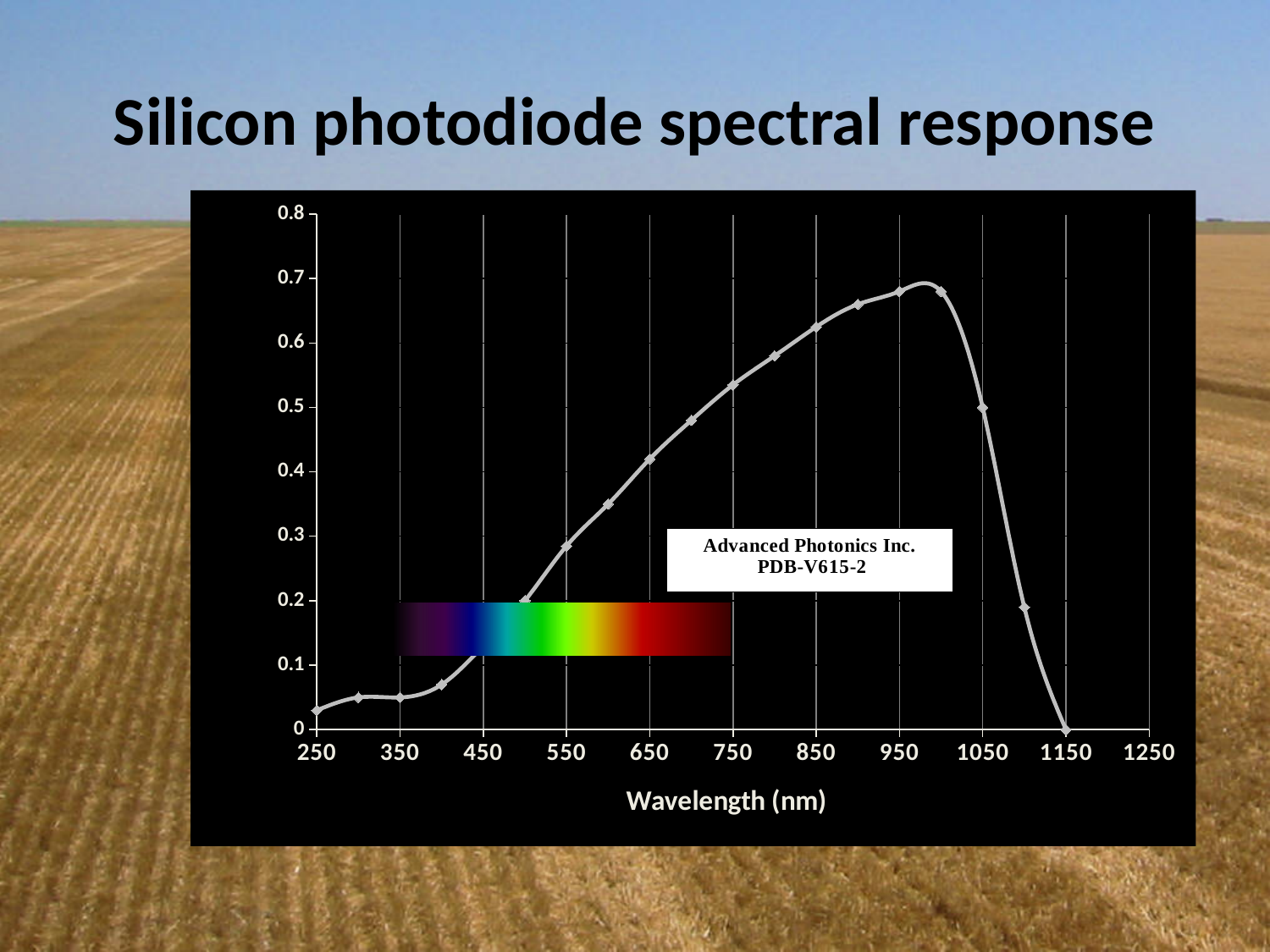
What is the title of the x axis? Wavelength (nm) Which wavelength has the higher value, 1100 nm or 700 nm? 700 nm Is the value at 650 nm greater or less than 0.4? greater What kind of chart is shown on the slide? line chart Is the value at 1100 nm greater or less than 0.3? less Is the value at 400 nm greater or less than 0.1? less At which wavelength is the plotted value lowest? 1150 nm Do the values rise or fall as wavelength increases from 250 nm to 950 nm? rise Which wavelength has the higher value, 900 nm or 600 nm? 900 nm What is the plotted value at 1150 nm? 0